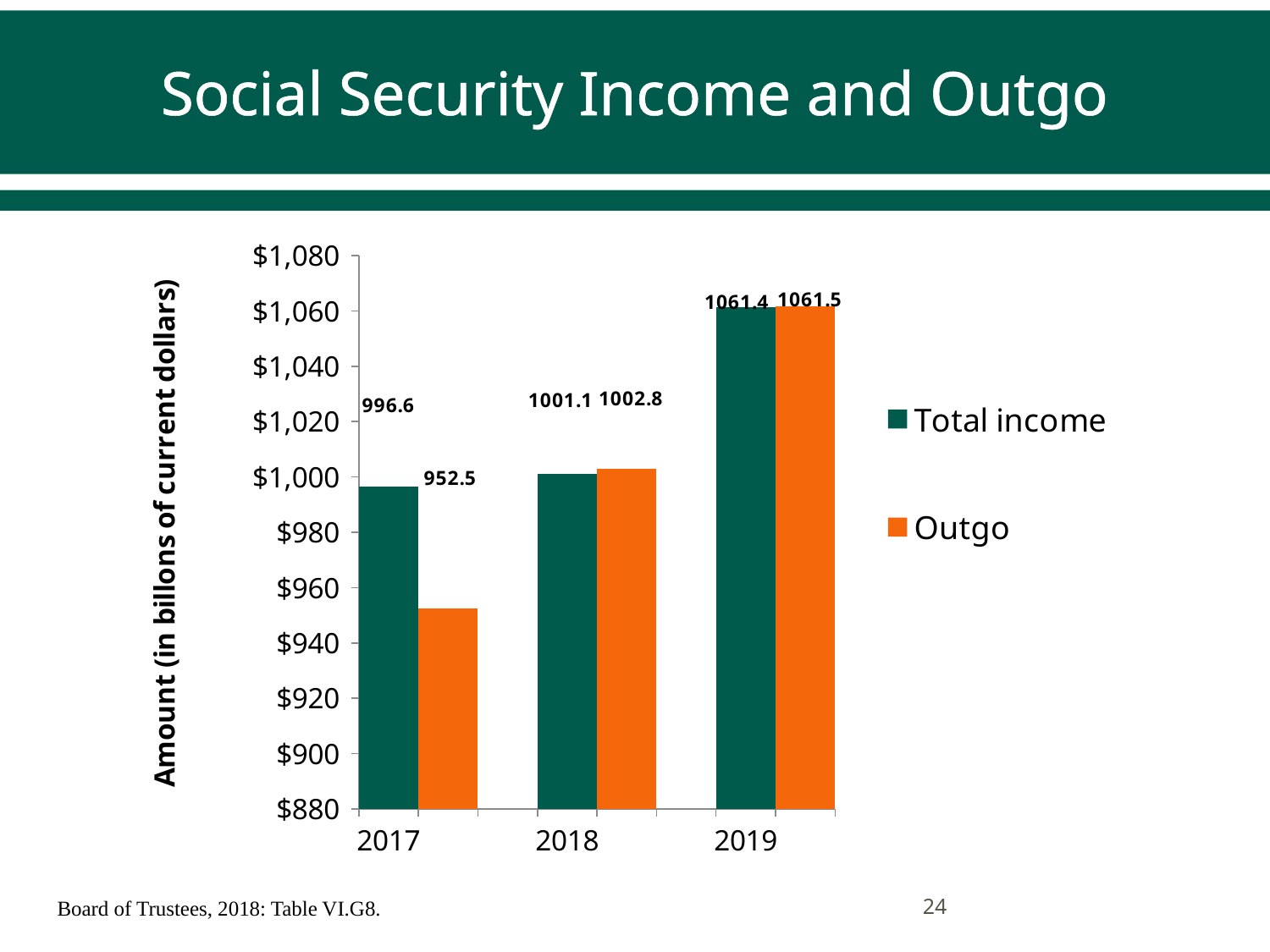
Which year has the highest Total income? 2019 Does Total income rise or fall from 2017 to 2019? Rise What is the difference between Total income and Outgo in 2017? 44.1 Which year has the lowest Outgo? 2017 By how much did Total income increase from 2017 to 2019? 64.8 What is the Outgo value for 2018? 1002.8 What kind of chart is shown on the slide? Bar chart How many series does the legend list? 2 What is the Outgo value for 2019? 1061.5 In 2017, which is larger, Total income or Outgo? Total income What is the Total income value for 2017? 996.6 How many years are shown on the x axis? 3